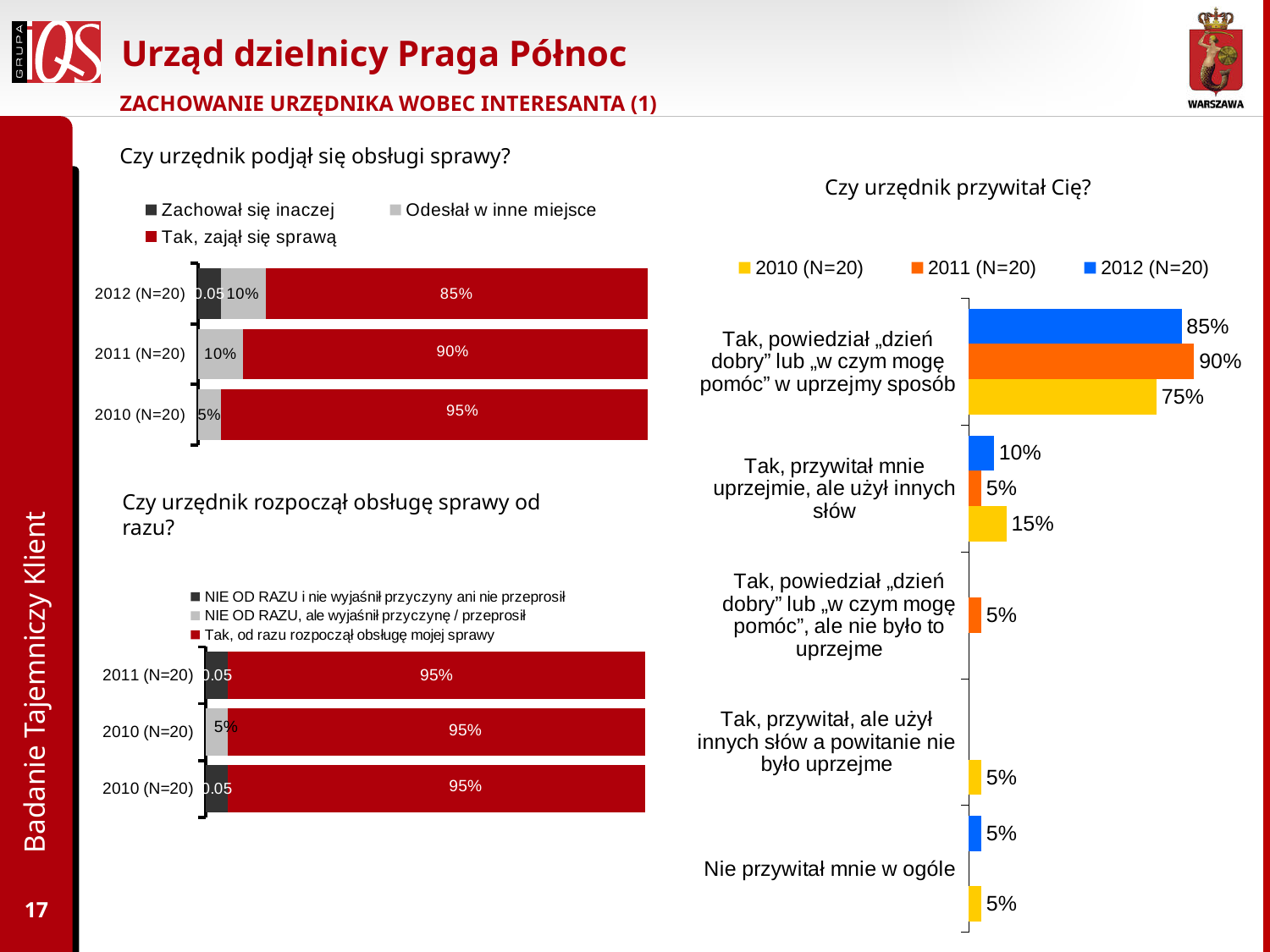
In the chart 'Czy urzędnik przywitał Cię?', what is the value for 2010 (N=20) in the category 'Tak, przywitał mnie uprzejmie, ale użył innych słów'? 15% In the chart 'Czy urzędnik podjął się obsługi sprawy?', what is the value of 'Tak, zajął się sprawą' for 2012 (N=20)? 85% In the chart 'Czy urzędnik podjął się obsługi sprawy?', which year has the highest value for 'Tak, zajął się sprawą'? 2010 (N=20) In the chart 'Czy urzędnik przywitał Cię?', what is the value for 2011 (N=20) in the category 'Tak, powiedział „dzień dobry” lub „w czym mogę pomóc” w uprzejmy sposób'? 90% How many series does the legend of the chart 'Czy urzędnik przywitał Cię?' list? 3 What type of chart is 'Czy urzędnik przywitał Cię?'? Bar chart In the chart 'Czy urzędnik podjął się obsługi sprawy?', is the 'Tak, zajął się sprawą' value larger for 2011 (N=20) or 2012 (N=20)? 2011 (N=20) In the chart 'Czy urzędnik przywitał Cię?', what is the difference between the 2011 and 2010 values for 'Tak, powiedział „dzień dobry” lub „w czym mogę pomóc” w uprzejmy sposób'? 15% In the chart 'Czy urzędnik podjął się obsługi sprawy?', what is the value of 'Odesłał w inne miejsce' for 2011 (N=20)? 10% In the chart 'Czy urzędnik przywitał Cię?', which year has the highest value for 'Tak, powiedział „dzień dobry” lub „w czym mogę pomóc” w uprzejmy sposób'? 2011 (N=20) How many categories are shown in the chart 'Czy urzędnik przywitał Cię?'? 5 In the chart 'Czy urzędnik rozpoczął obsługę sprawy od razu?', what is the value of 'Tak, od razu rozpoczął obsługę mojej sprawy' for 2011 (N=20)? 95%